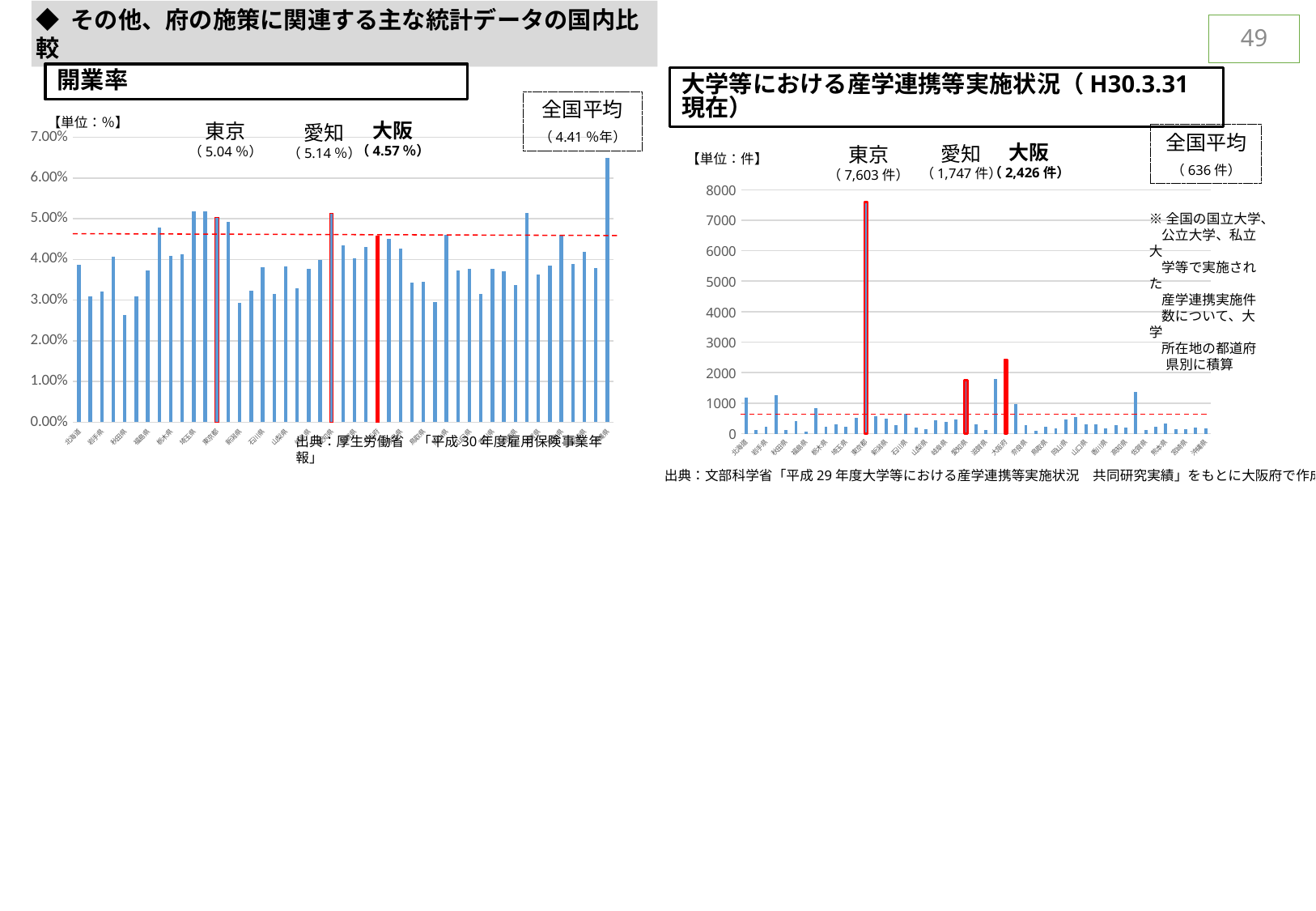
In the 開業率 chart, is the value for 大阪 greater or less than 4.00%? greater In the 大学等における産学連携等実施状況 chart, which prefecture has the highest value? 東京 In the 大学等における産学連携等実施状況 chart, what is the value printed for 東京? 7,603件 In the 大学等における産学連携等実施状況 chart, what is the 全国平均 value shown? 636件 In the 大学等における産学連携等実施状況 chart, what is the value printed for 大阪? 2,426件 In the 開業率 chart, what is the value printed for 東京? 5.04% What kind of chart is the 大学等における産学連携等実施状況 chart? bar chart In the 開業率 chart, what is the value printed for 大阪? 4.57% In the 開業率 chart, what is the difference between the values for 愛知 and 東京? 0.10% In the 開業率 chart, which has the higher value, 愛知 or 東京? 愛知 In the 大学等における産学連携等実施状況 chart, what is the difference between the values for 大阪 and 愛知? 679件 In the 開業率 chart, what is the 全国平均 value shown? 4.41%